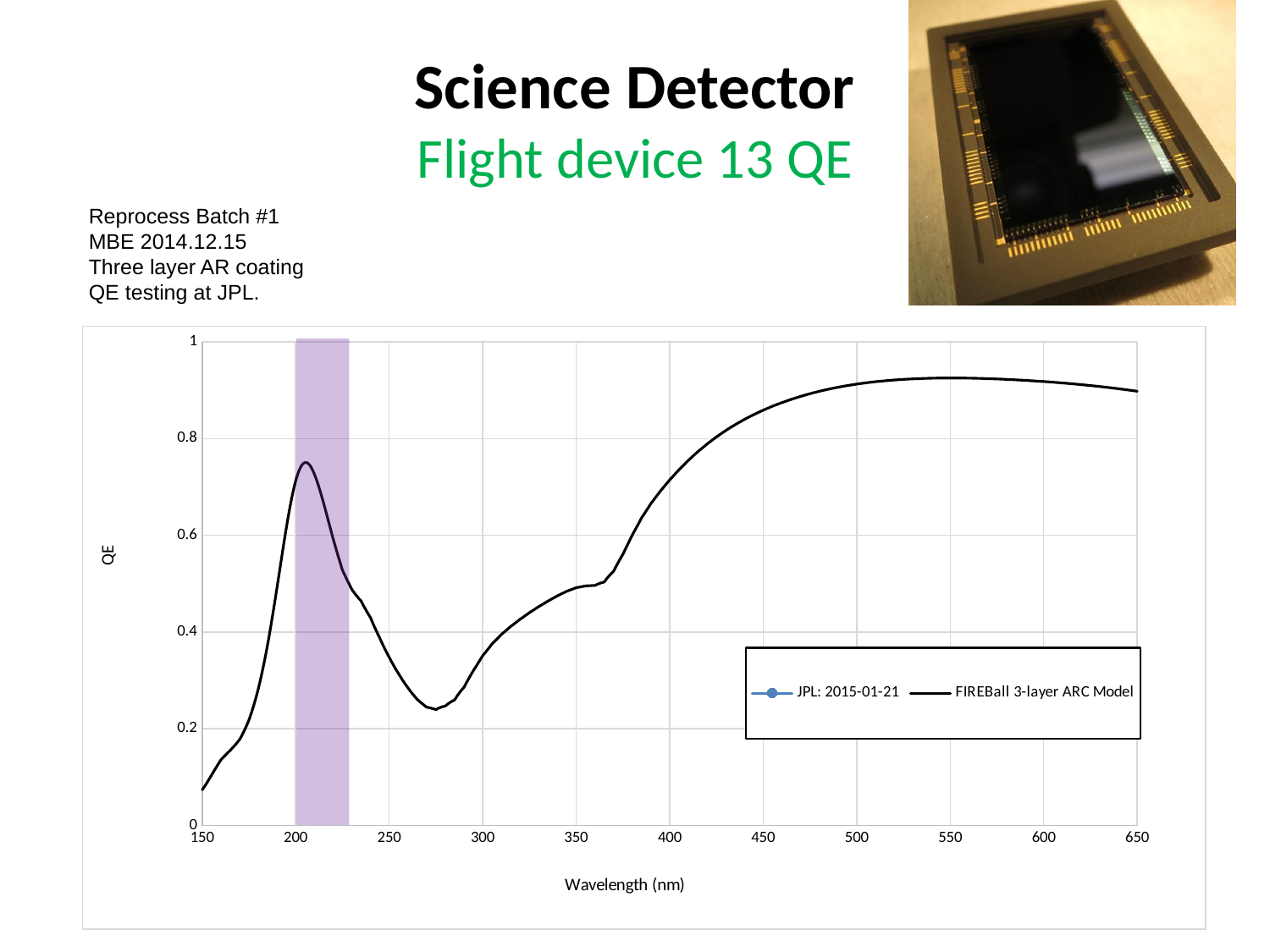
Does the FIREBall 3-layer ARC Model QE rise or fall between 400 nm and 550 nm? rise Is the QE value of the FIREBall 3-layer ARC Model at 550 nm greater or less than 0.8? greater Is the QE value of the FIREBall 3-layer ARC Model at 150 nm greater or less than 0.2? less Does the FIREBall 3-layer ARC Model QE rise or fall between 210 nm and 275 nm? fall What is the label of the x axis of the chart? Wavelength (nm) How many series does the chart legend list? 2 Is the QE value of the FIREBall 3-layer ARC Model at 200 nm greater or less than 0.6? greater What is the label of the y axis of the chart? QE Is the FIREBall 3-layer ARC Model QE higher at 200 nm or at 550 nm? 550 nm What kind of chart is shown on the slide? line chart